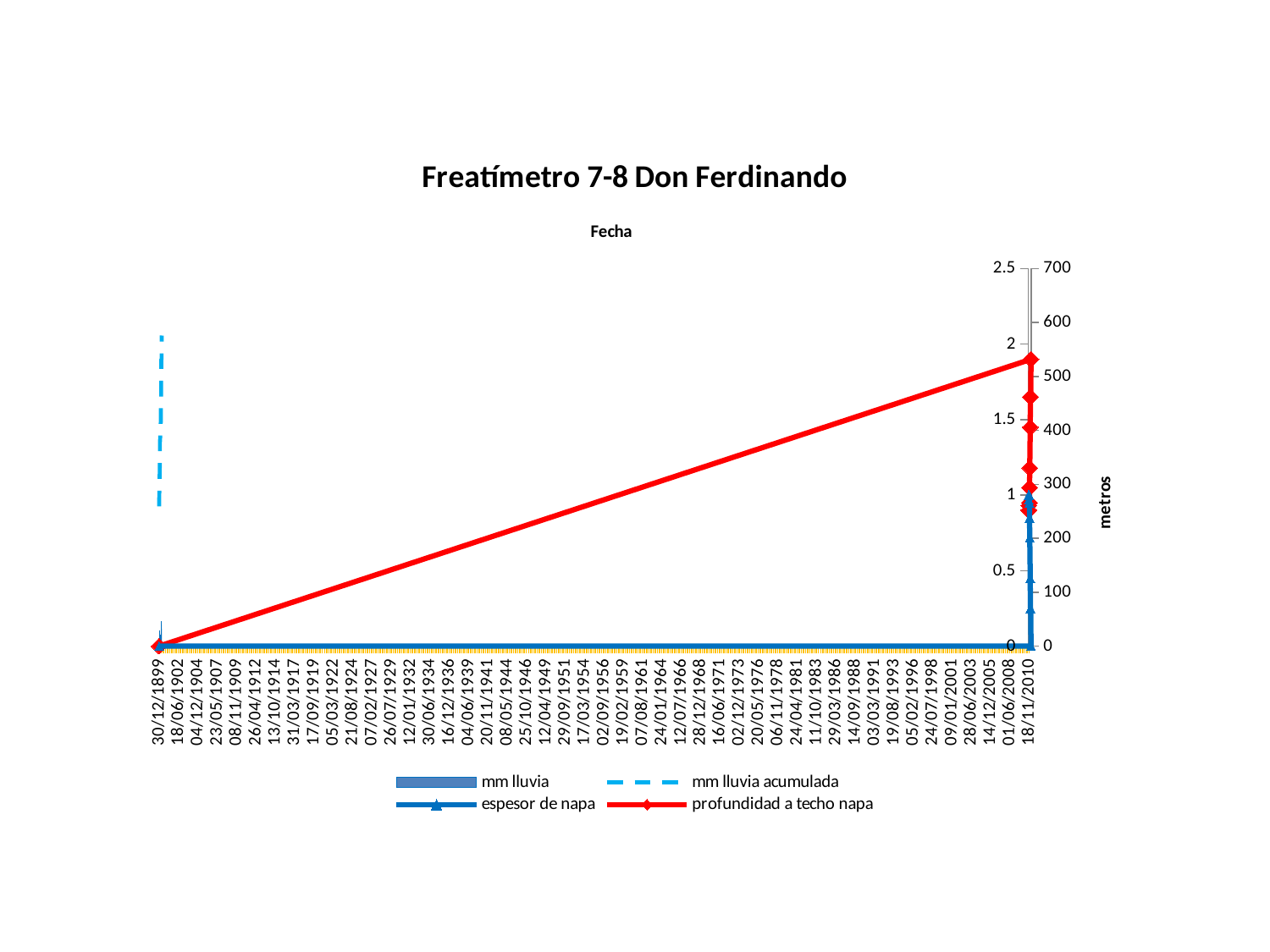
What is the last date shown on the x axis? 18/11/2010 What is the label of the right-hand vertical axis? metros What is the title of the chart? Freatímetro 7-8 Don Ferdinando Does the 'profundidad a techo napa' line rise or fall from 30/12/1899 to 18/11/2010? rises How many series does the legend list? 4 What is the first date shown on the x axis? 30/12/1899 What kind of chart is this? combination bar and line chart What is the value of 'profundidad a techo napa' at 30/12/1899? 0